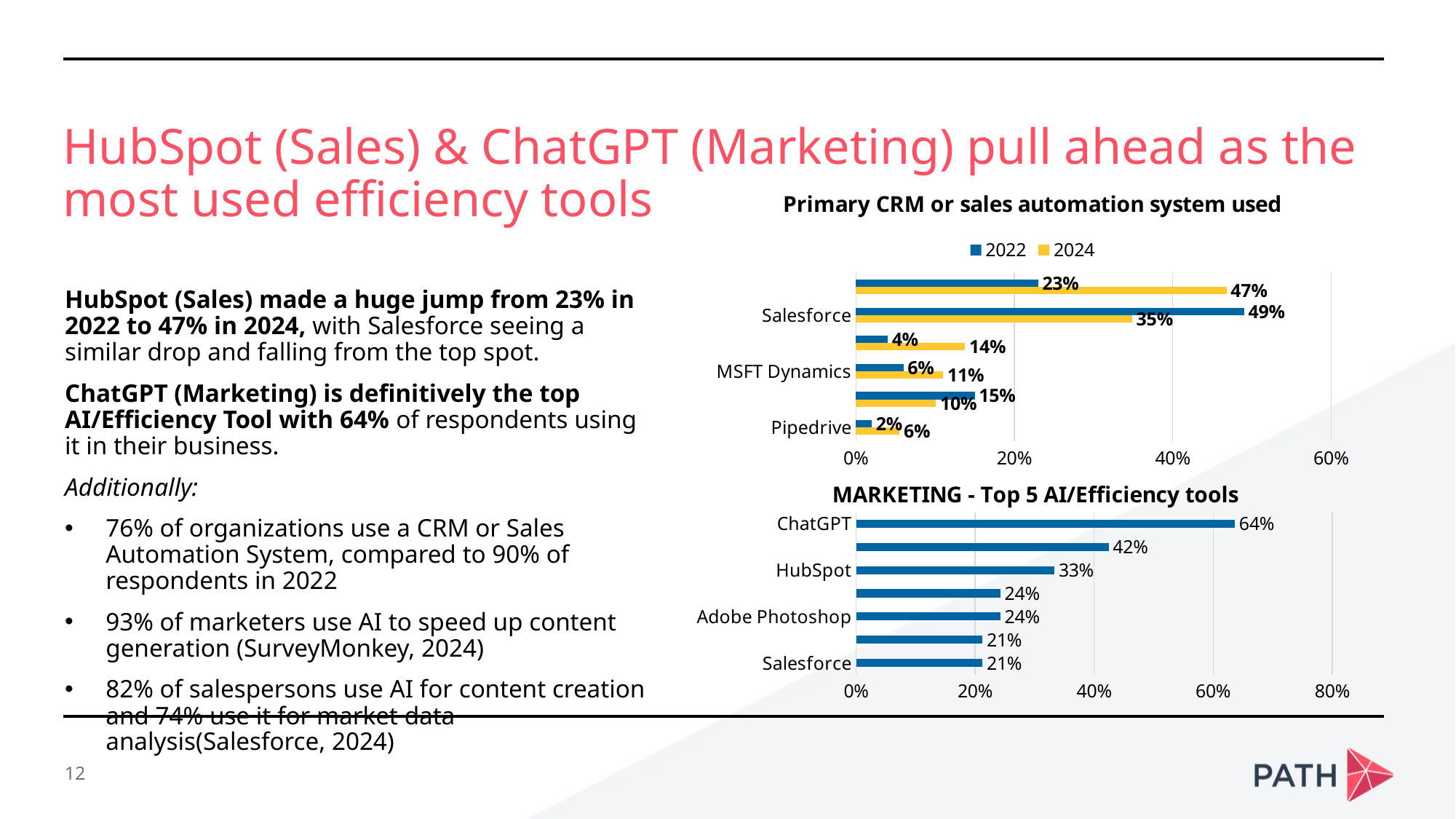
In the 'MARKETING - Top 5 AI/Efficiency tools' chart, what is the value for HubSpot? 33% In the 'Primary CRM or sales automation system used' chart, by how many percentage points did Salesforce fall from 2022 to 2024? 14 percentage points In the 'Primary CRM or sales automation system used' chart, what is the 2024 value for MSFT Dynamics? 11% In the 'Primary CRM or sales automation system used' chart, what is the 2024 value for Salesforce? 35% In the 'MARKETING - Top 5 AI/Efficiency tools' chart, what is the value for ChatGPT? 64% In the 'MARKETING - Top 5 AI/Efficiency tools' chart, which tool has the highest value? ChatGPT What kind of chart is the 'Primary CRM or sales automation system used' chart? Bar chart In the 'MARKETING - Top 5 AI/Efficiency tools' chart, what is the difference between the values for ChatGPT and HubSpot? 31 percentage points In the 'Primary CRM or sales automation system used' chart, what is the 2022 value for Pipedrive? 2% In the 'Primary CRM or sales automation system used' chart, what is the 2022 value for Salesforce? 49% How many series does the legend of the 'Primary CRM or sales automation system used' chart list? 2 In the 'MARKETING - Top 5 AI/Efficiency tools' chart, which is larger, the value for Adobe Photoshop or the value for Salesforce? Adobe Photoshop